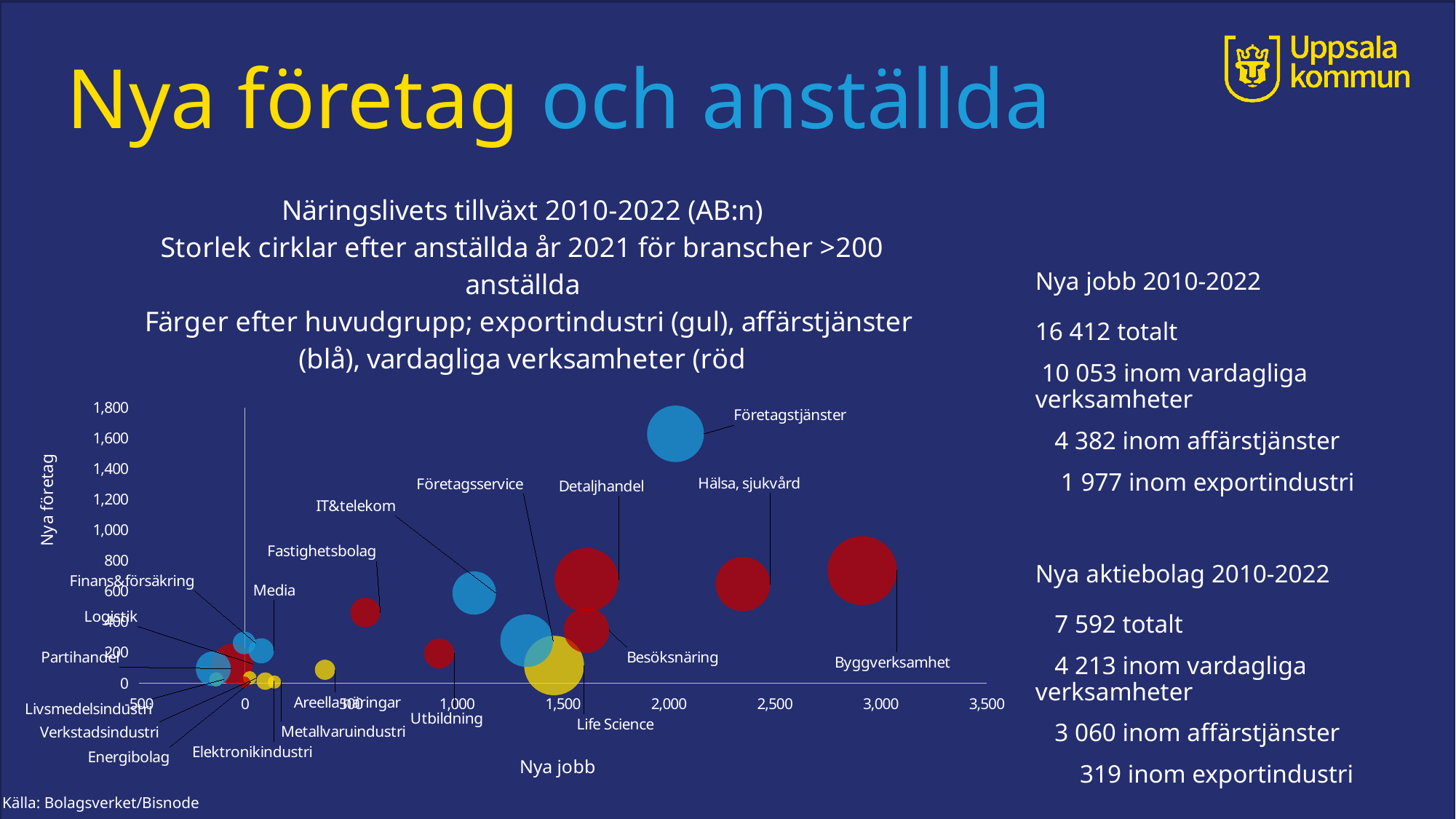
Is the Nya företag value for IT&telekom greater or less than 400? greater What kind of chart is shown on the slide? Bubble chart Is the Nya företag value for Företagstjänster greater or less than 1,400? greater Is the Nya jobb value for Byggverksamhet greater or less than 2,500? greater Which has more Nya företag, Företagstjänster or Byggverksamhet? Företagstjänster Which industry has the highest value for Nya jobb? Byggverksamhet Which industry has the highest value for Nya företag? Företagstjänster What colour is the bubble for Life Science? Yellow Which has more Nya jobb, Byggverksamhet or Detaljhandel? Byggverksamhet What is the title of the horizontal axis of the chart? Nya jobb